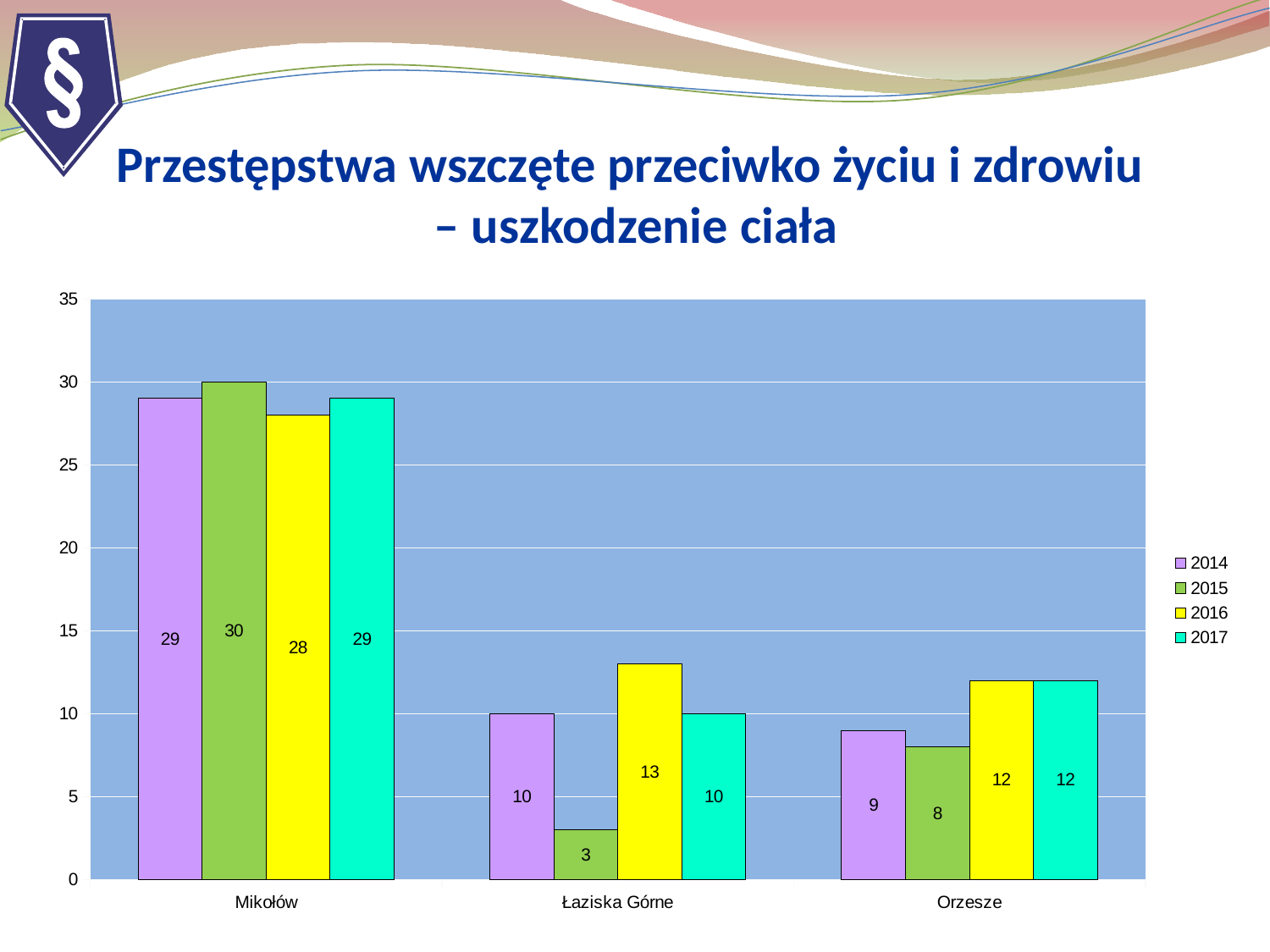
What is the value for Mikołów in 2015? 30 Which category has the highest value in 2017? Mikołów What is the value for Orzesze in 2014? 9 What is the difference between the 2016 and 2015 values for Łaziska Górne? 10 What kind of chart is shown on the slide? bar chart How many categories are shown on the x axis? 3 Which category has the lowest value in 2015? Łaziska Górne Is the value for Mikołów in 2016 greater or less than 25? greater Which is larger for Orzesze: the 2014 value or the 2016 value? 2016 What is the value for Łaziska Górne in 2016? 13 Which year is shown in yellow in the legend? 2016 How many series does the legend list? 4